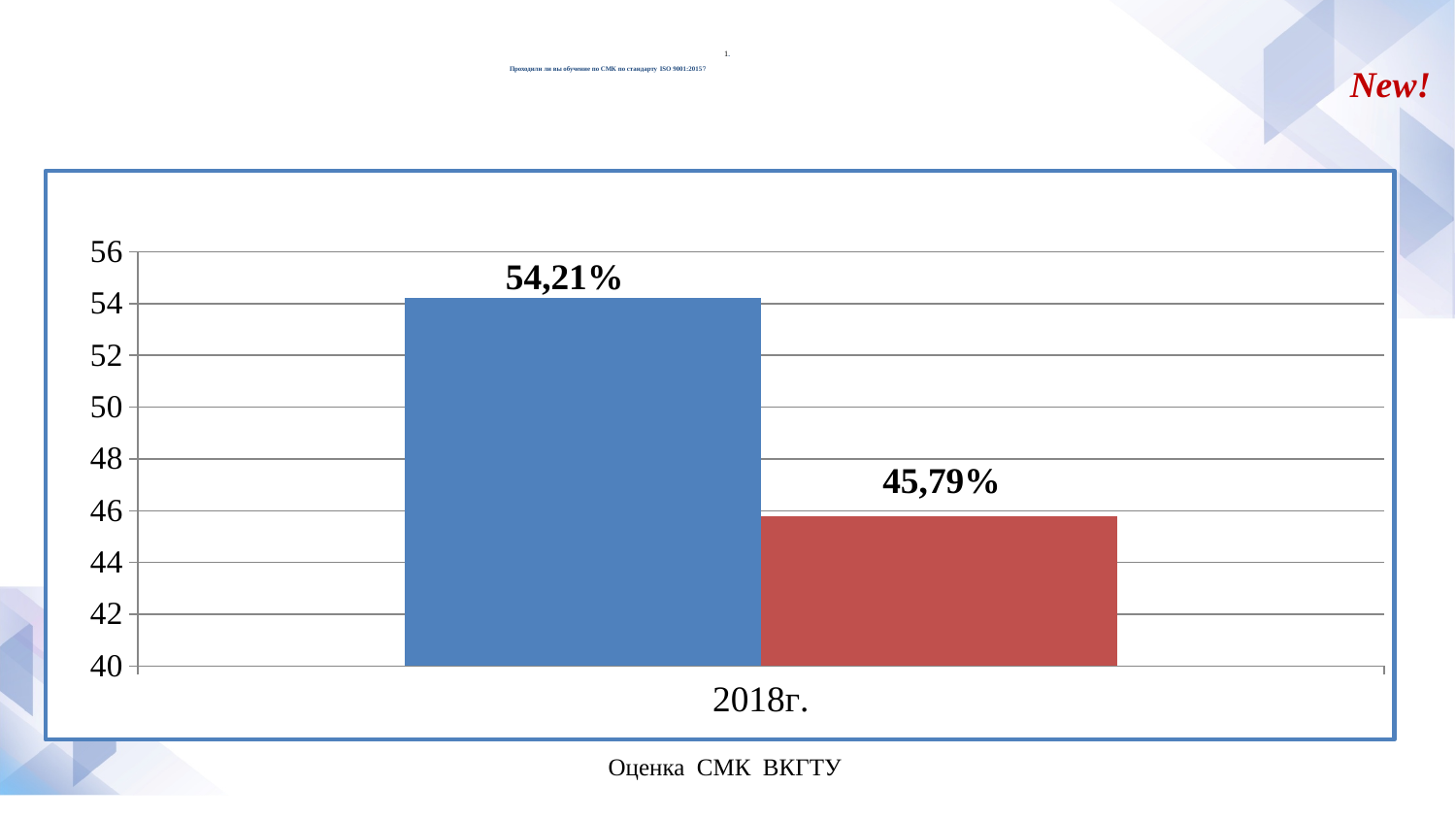
How many categories are shown on the x axis? 1 What is the difference between the blue bar's value and the red bar's value? 8,42% What value is shown on the blue bar? 54,21% Is the value of the blue bar greater or less than 50? greater Which bar is taller, the blue one or the red one? the blue one Is the value of the red bar greater or less than 48? less What is the category label on the x axis? 2018г. Which bar has the lowest value? the red bar What value is shown on the red bar? 45,79% Is the value of the red bar larger or smaller than the value of the blue bar? smaller What is the lowest value shown on the y axis? 40 What kind of chart is shown on the slide? bar chart